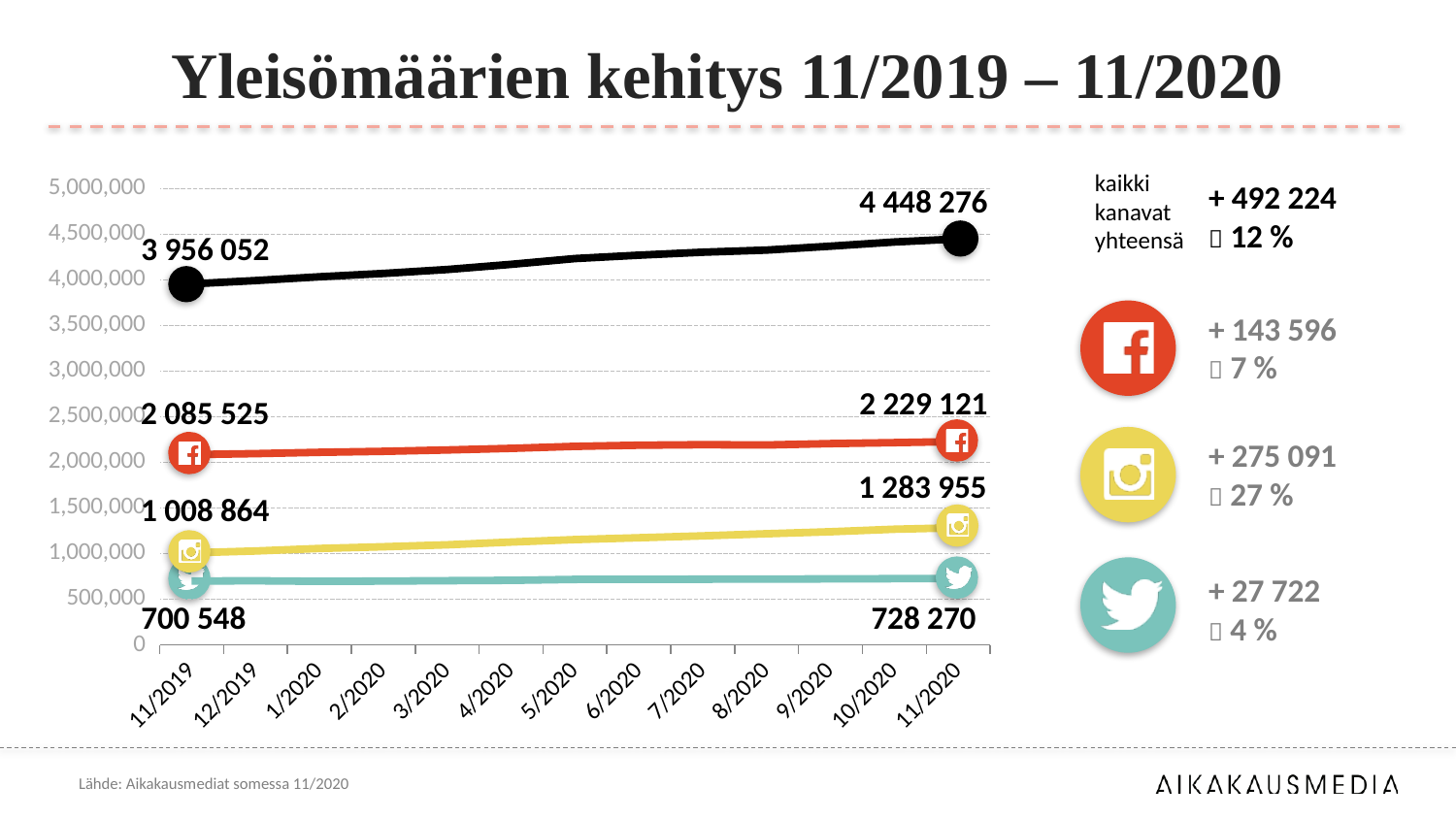
What is the Twitter value at 11/2020? 728 270 What type of chart is shown on the slide? line chart How many months are shown on the x axis? 13 Which is larger at 11/2019, the Facebook value or the Instagram value? Facebook What is the value of the black (total) line at 11/2019? 3 956 052 What is the value of the black (total) line at 11/2020? 4 448 276 What is the Facebook value at 11/2020? 2 229 121 Which channel has the lowest value at 11/2020: Facebook, Instagram or Twitter? Twitter What is the Instagram value at 11/2019? 1 008 864 Does the Instagram line rise or fall from 11/2019 to 11/2020? rise By how much did the Instagram value increase from 11/2019 to 11/2020? 275 091 By how much did the Facebook value increase from 11/2019 to 11/2020? 143 596